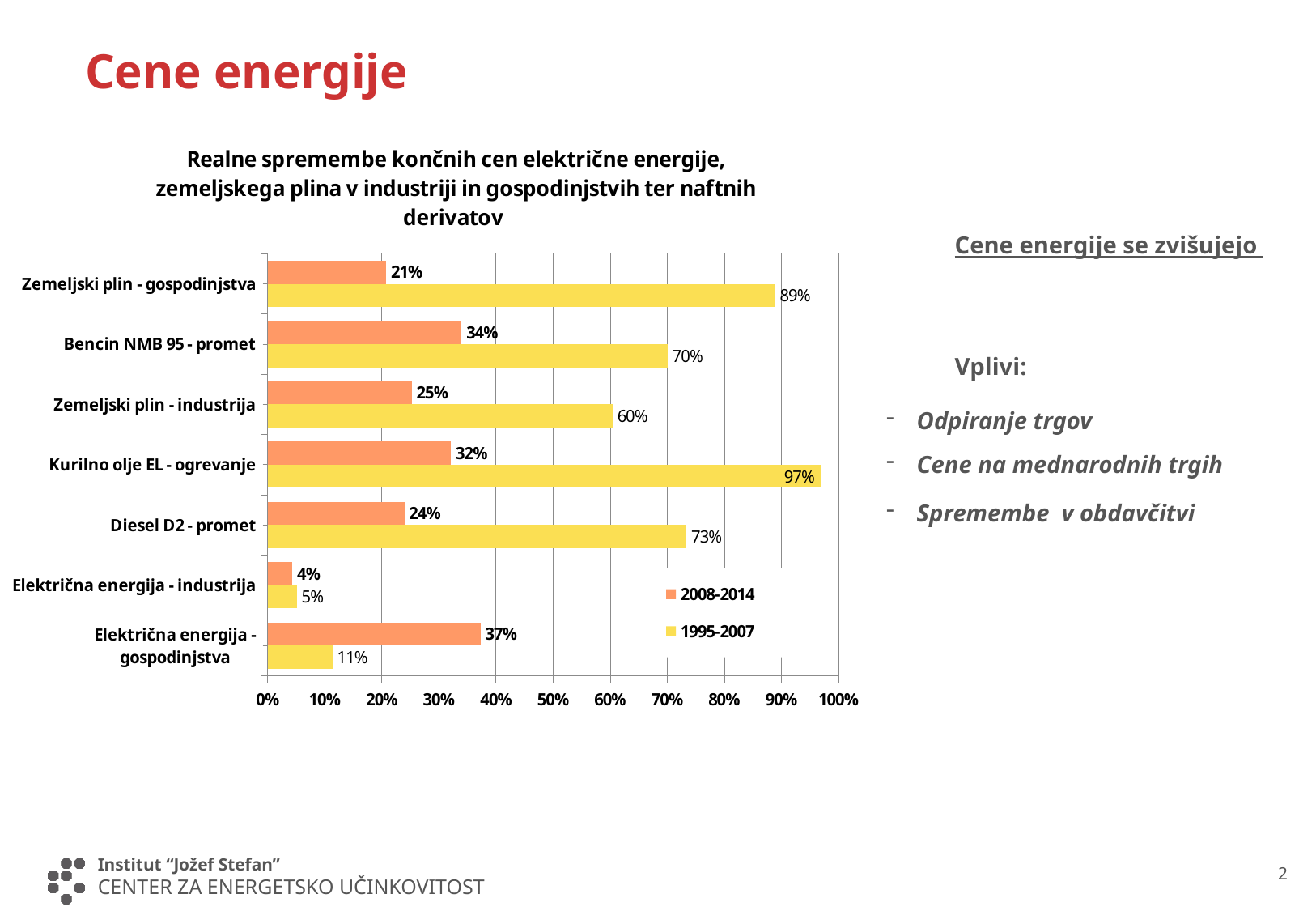
What kind of chart is shown on the slide? Bar chart What is the 2008-2014 value for Bencin NMB 95 - promet? 34% What is the 1995-2007 value for Kurilno olje EL - ogrevanje? 97% Which category has the highest 1995-2007 value? Kurilno olje EL - ogrevanje Which category has the lowest 2008-2014 value? Električna energija - industrija How many series does the legend list? 2 Which colour represents the 1995-2007 series? Yellow What is the 1995-2007 value for Zemeljski plin - gospodinjstva? 89% What is the difference between the 1995-2007 and 2008-2014 values for Diesel D2 - promet? 49% For Električna energija - gospodinjstva, which period has the larger value, 2008-2014 or 1995-2007? 2008-2014 How many categories are shown on the chart? 7 What is the 2008-2014 value for Električna energija - gospodinjstva? 37%